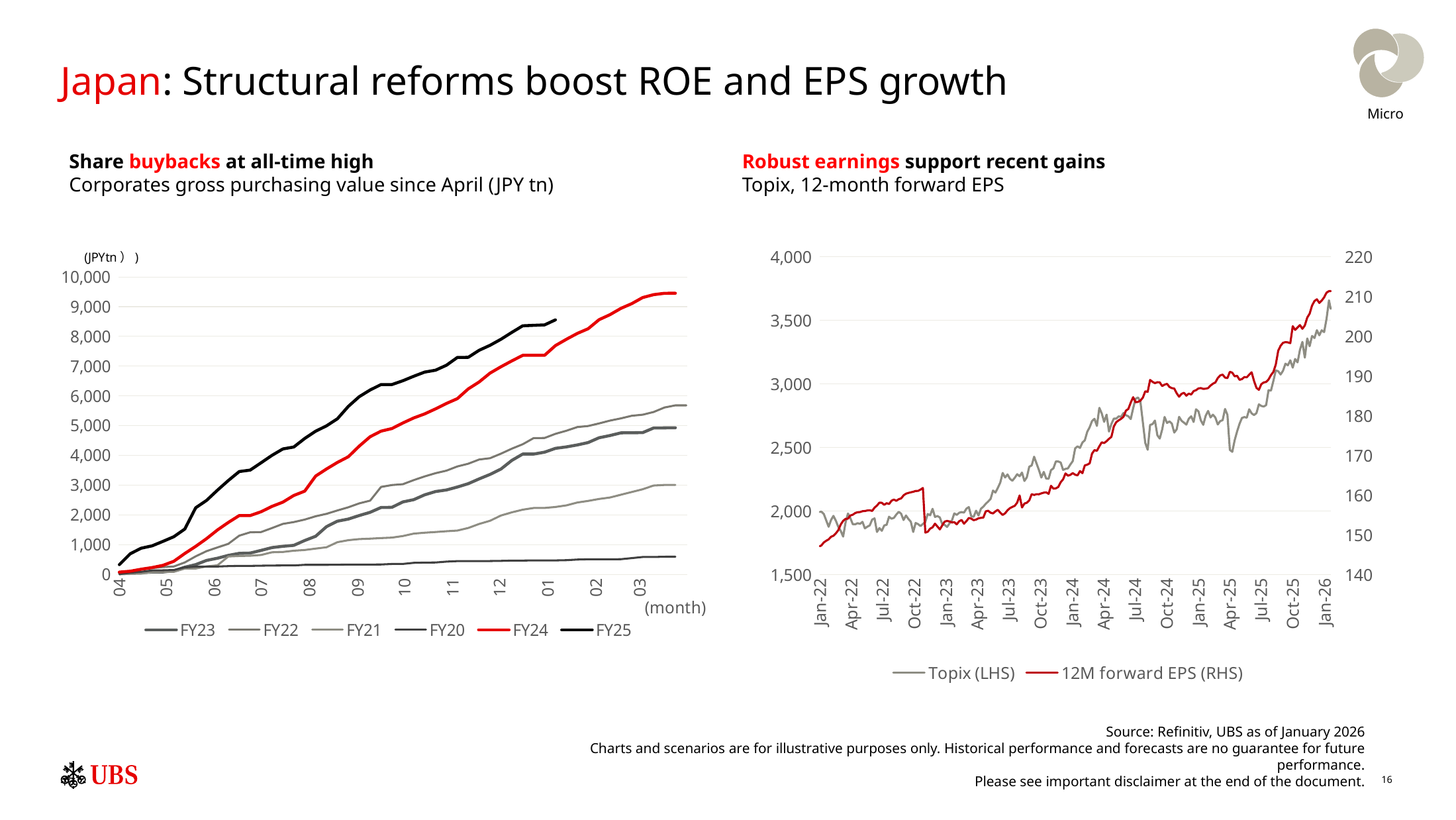
On the left chart (Share buybacks at all-time high), which series stays lowest across the months? FY20 On the right chart (Robust earnings support recent gains), does the 12M forward EPS (RHS) series generally rise or fall from Jan-22 to Jan-26? rise On the right chart (Robust earnings support recent gains), is the value for 12M forward EPS (RHS) at Jan-22 greater or less than 150? less On the left chart (Share buybacks at all-time high), which series reaches the highest value? FY24 On the left chart (Share buybacks at all-time high), is the value for FY25 at month 01 greater or less than 8,000? greater On the right chart (Robust earnings support recent gains), how many series does the legend list? 2 On the right chart (Robust earnings support recent gains), is the value for Topix (LHS) at Jan-26 greater or less than 3,500? greater On the left chart (Share buybacks at all-time high), how many month labels are shown on the x axis? 12 On the left chart (Share buybacks at all-time high), what kind of chart is it? line chart On the left chart (Share buybacks at all-time high), at month 10, which is larger: FY25 or FY24? FY25 On the left chart (Share buybacks at all-time high), how many series does the legend list? 6